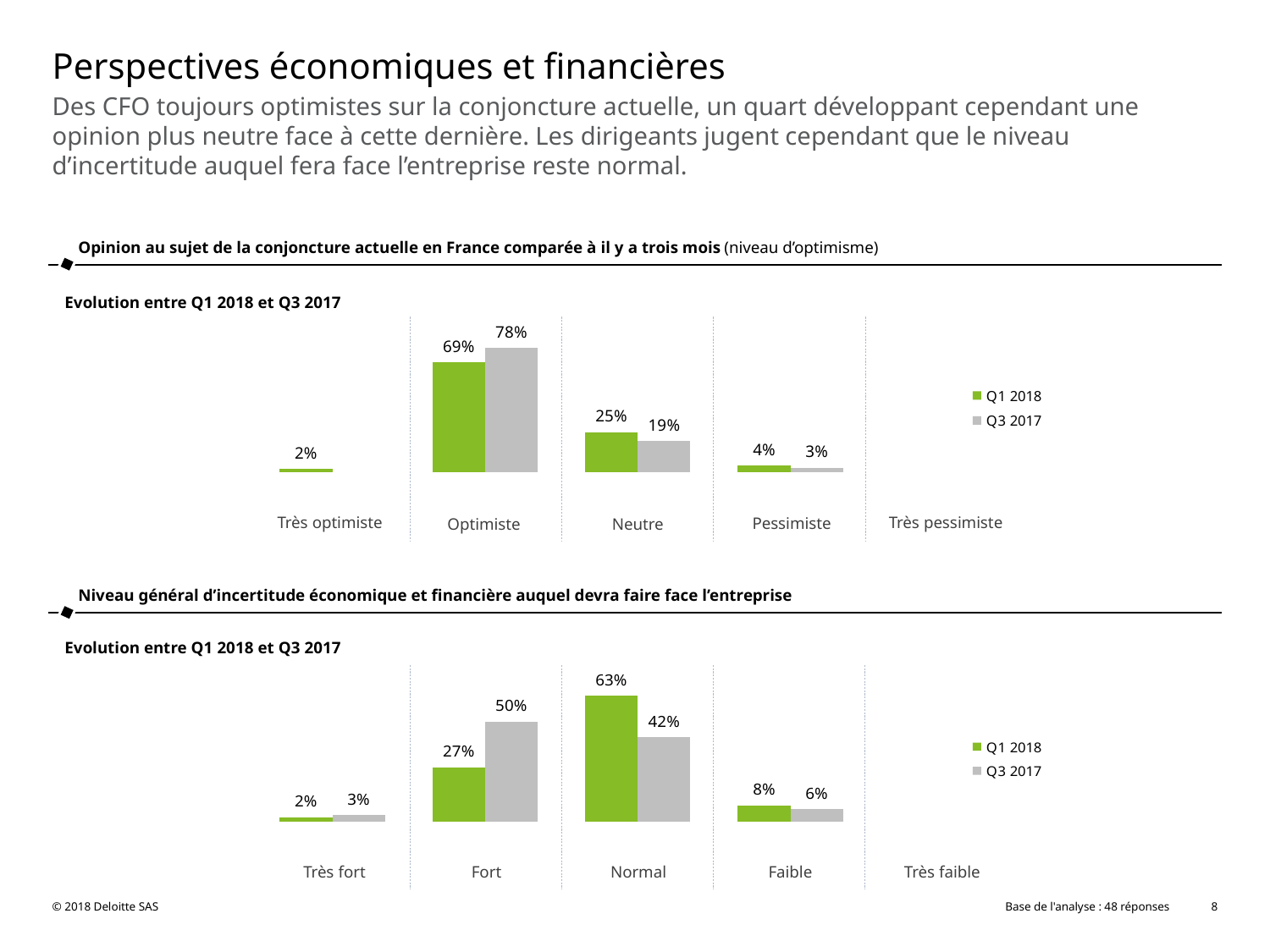
In the top chart (Opinion au sujet de la conjoncture actuelle), what is the Q3 2017 value for Neutre? 19% In the bottom chart (Niveau général d'incertitude), what is the Q3 2017 value for Fort? 50% In the bottom chart (Niveau général d'incertitude), which category has the highest Q1 2018 value? Normal In the top chart (Opinion au sujet de la conjoncture actuelle), is the Q1 2018 value for Neutre larger or smaller than the Q3 2017 value for Neutre? larger In the bottom chart (Niveau général d'incertitude), what is the Q1 2018 value for Normal? 63% In the bottom chart (Niveau général d'incertitude), what is the difference between the Q1 2018 and Q3 2017 values for Normal? 21% What type of chart is the bottom chart (Niveau général d'incertitude)? Bar chart In the top chart (Opinion au sujet de la conjoncture actuelle), what is the Q1 2018 value for Optimiste? 69% In the top chart (Opinion au sujet de la conjoncture actuelle), how many series does the legend list? 2 In the top chart (Opinion au sujet de la conjoncture actuelle), what is the difference between the Q3 2017 and Q1 2018 values for Optimiste? 9% In the bottom chart (Niveau général d'incertitude), how many categories are shown on the x axis? 5 In the top chart (Opinion au sujet de la conjoncture actuelle), which category has the highest Q3 2017 value? Optimiste